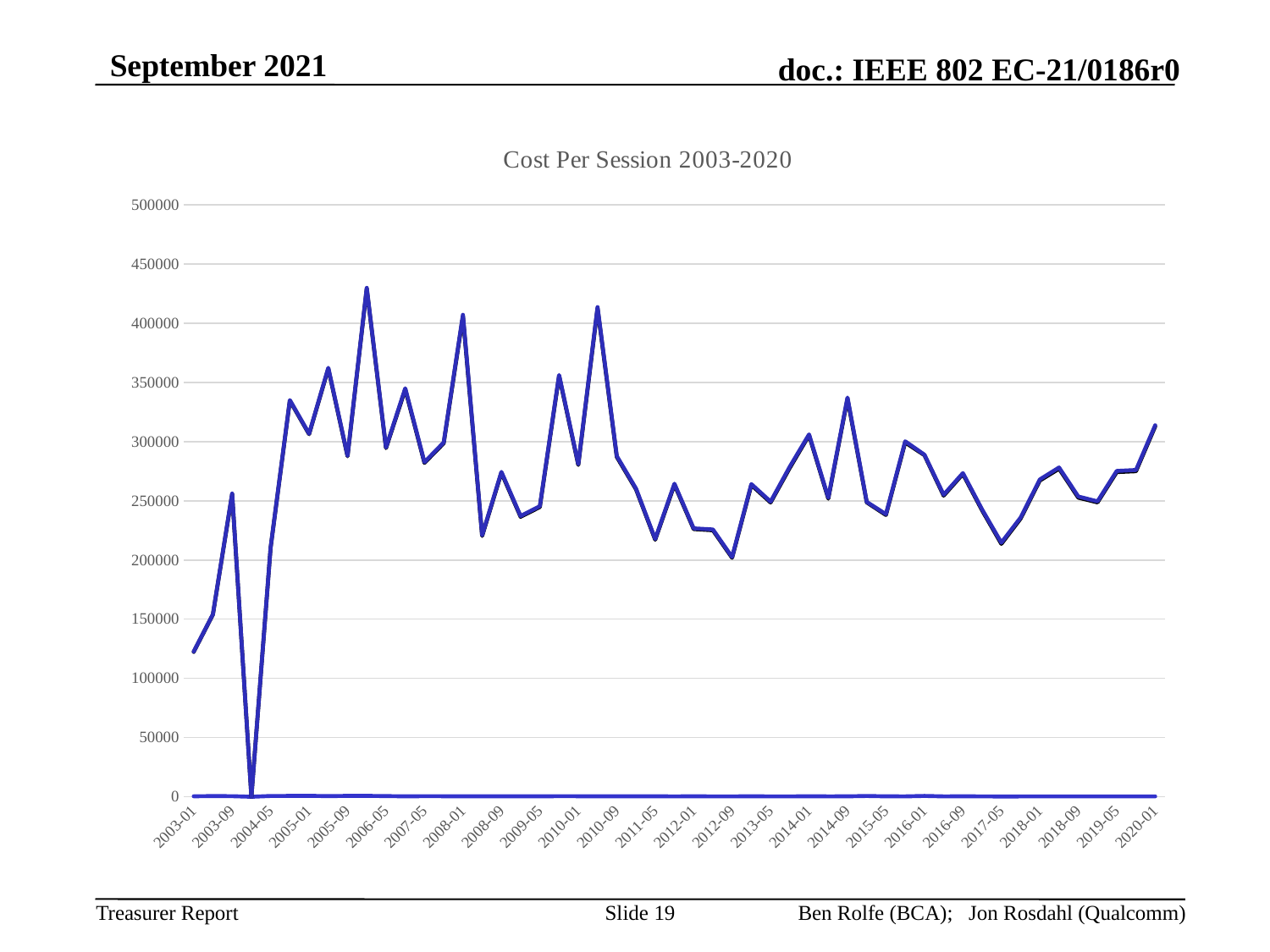
Is the value for 2012-09 greater or less than 250000? less Which is larger, the value for 2012-09 or the value for 2014-09? 2014-09 Which is larger, the value for 2003-01 or the value for 2005-01? 2005-01 What is the title of the chart? Cost Per Session 2003-2020 Is the value for 2014-09 greater or less than 300000? greater Is the value for 2008-09 greater or less than 250000? greater What kind of chart is shown on the slide? line chart Does the line rise or fall between 2003-01 and 2003-09? rise